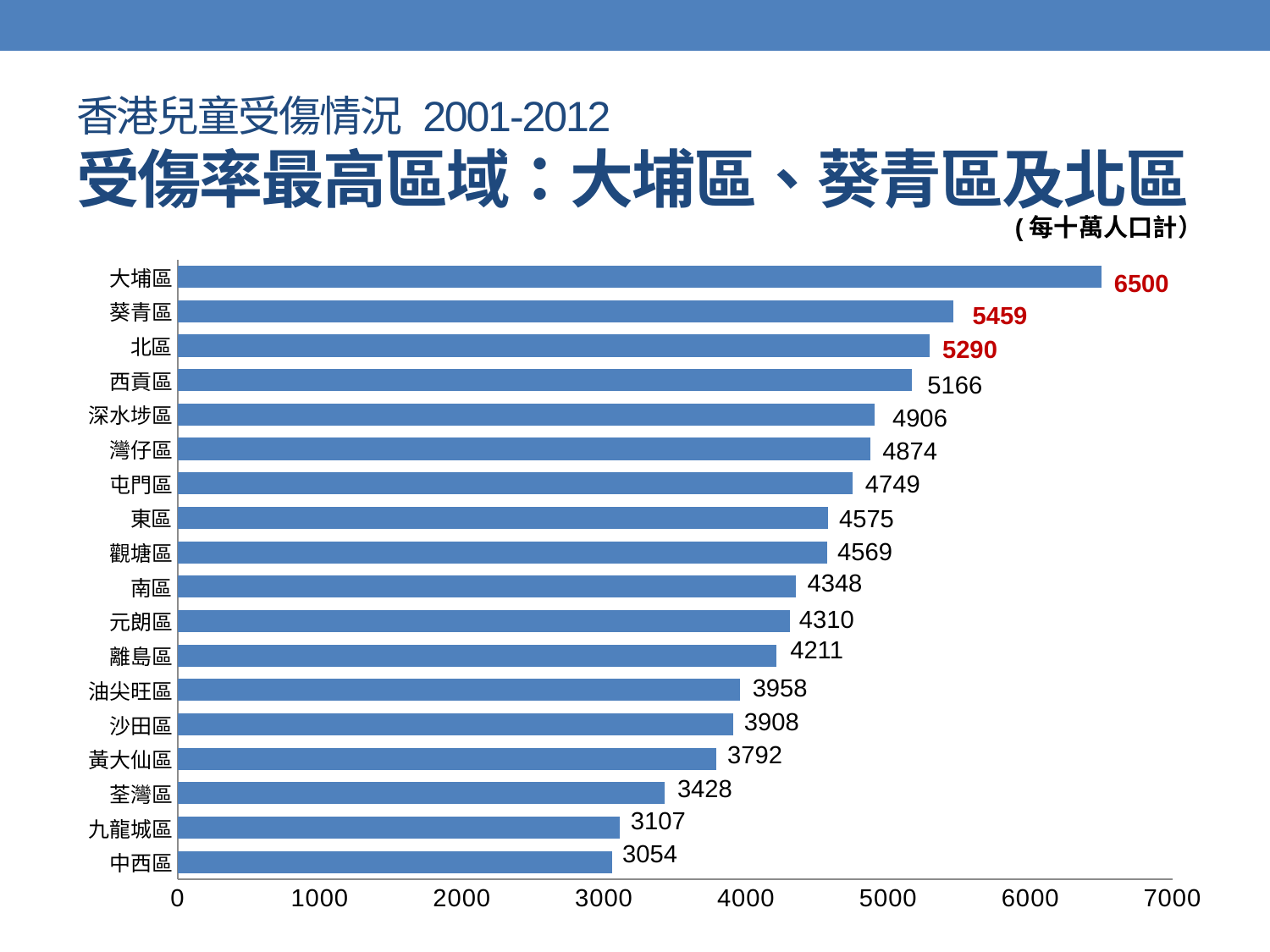
What kind of chart is shown on the slide? bar chart Is the value for 荃灣區 greater or less than 4000? less What is the value for 大埔區? 6500 What is the difference between the values for 大埔區 and 葵青區? 1041 Which district has the lowest value? 中西區 Which district has the highest value? 大埔區 How many districts are shown in the chart? 18 What is the difference between the values for 北區 and 西貢區? 124 Which is larger, the value for 屯門區 or the value for 元朗區? 屯門區 What is the value for 沙田區? 3908 How many data labels are printed in red? 3 What is the value for 離島區? 4211